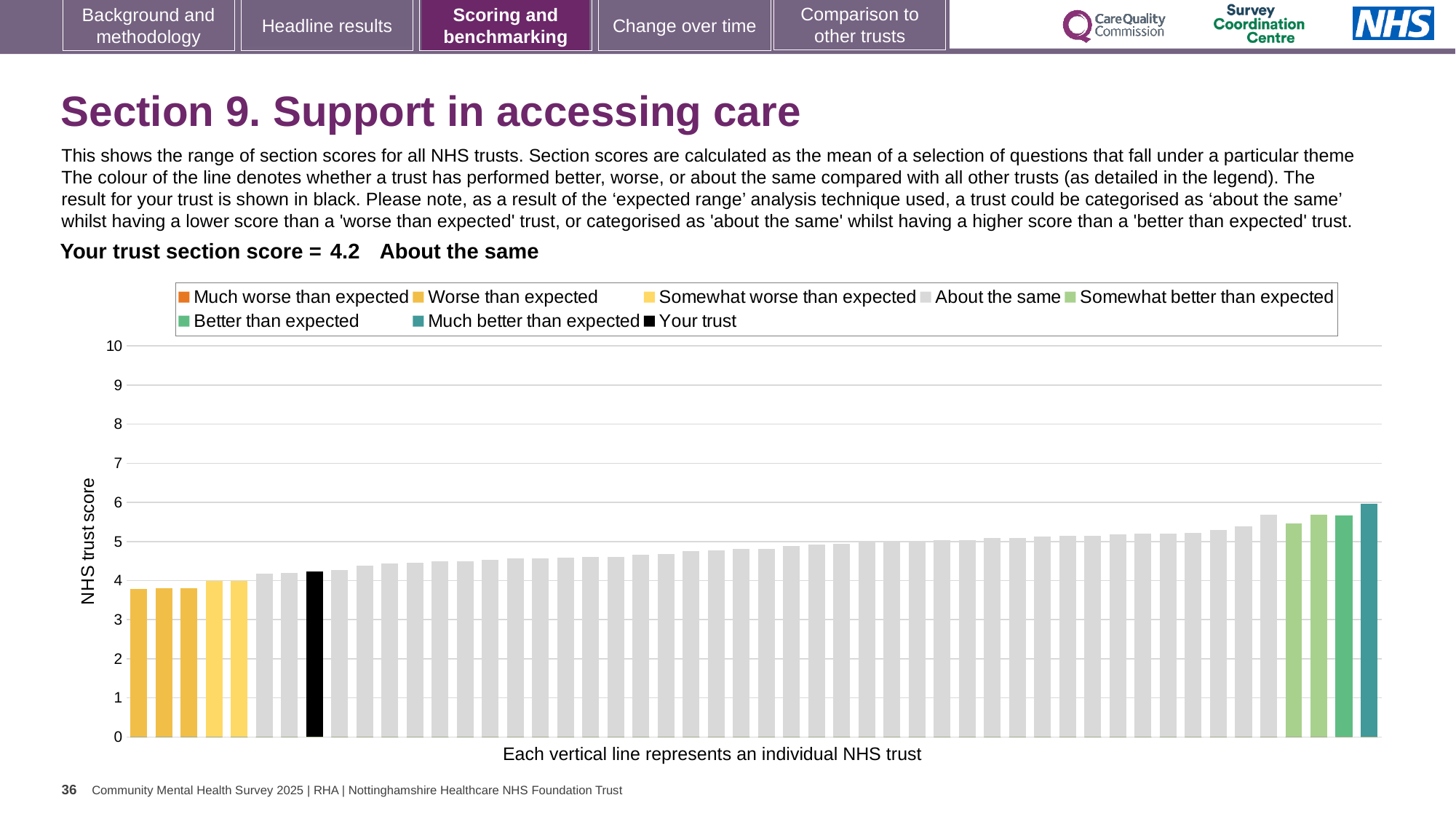
Do the bar values rise or fall from left to right along the x axis? rise What colour is the bar representing your trust? Black How many bars are coloured as 'Worse than expected'? 3 Is the value of the shortest bar in the chart greater or less than 4? less How is your trust's section score categorised compared with other trusts? About the same What is the section score for your trust shown on the slide? 4.2 What is the label on the y axis of the chart? NHS trust score Is the value for your trust (the black bar) greater or less than 5? less Which legend category does the tallest bar in the chart belong to? Much better than expected What kind of chart is shown on the slide? Bar chart Is the value of the tallest bar in the chart greater or less than 5? greater How many entries does the chart legend list? 8